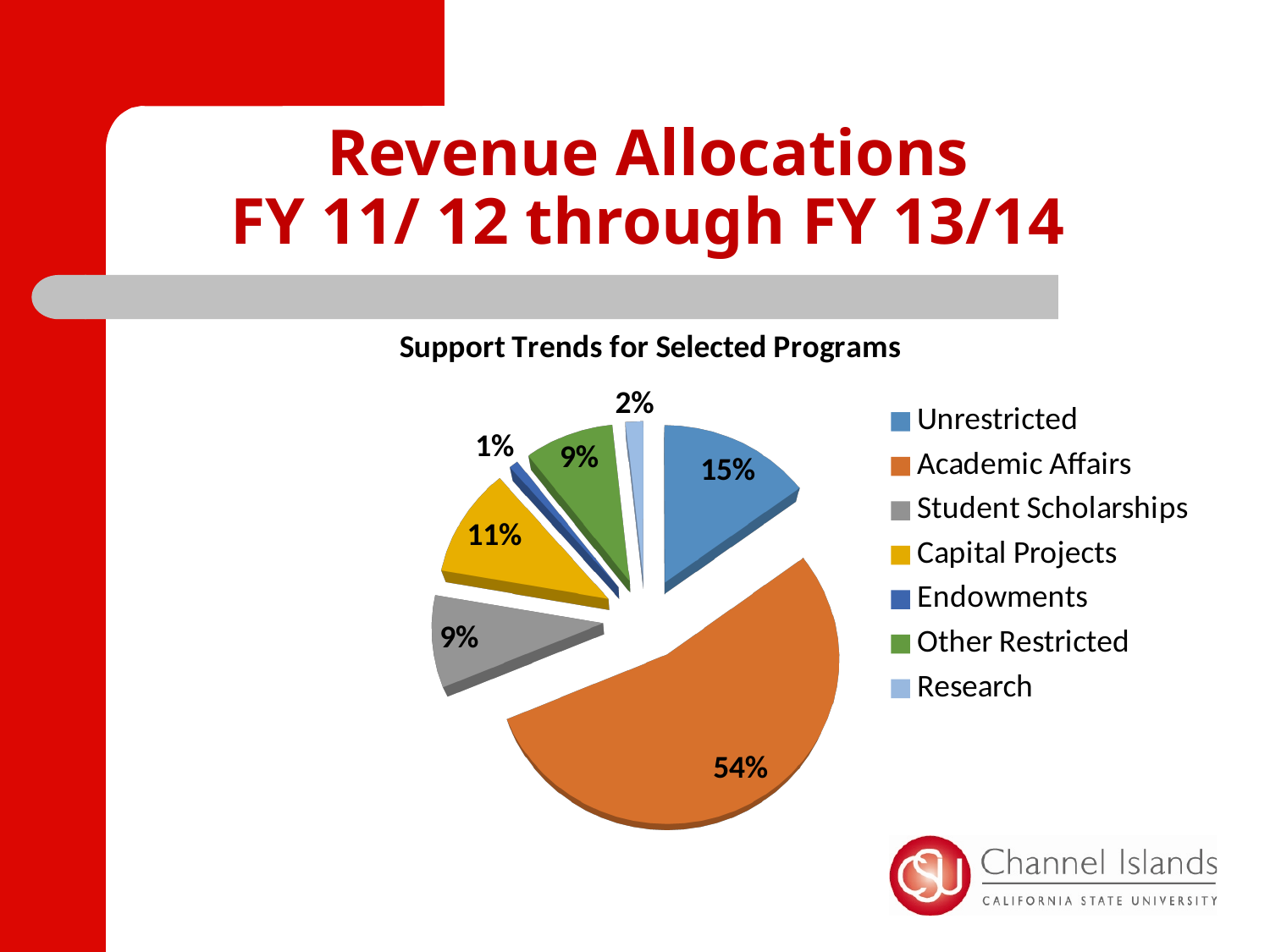
What share of the pie does Unrestricted represent? 15% Which category has the largest slice of the pie? Academic Affairs What share of the pie does Capital Projects represent? 11% What kind of chart is shown on the slide? Pie chart Which is larger, the share for Capital Projects or the share for Student Scholarships? Capital Projects Which category has the smallest slice of the pie? Endowments What share of the pie does Research represent? 2% What is the title of the chart? Support Trends for Selected Programs What is the difference in percentage points between Academic Affairs and Unrestricted? 39 percentage points How many categories does the legend list? 7